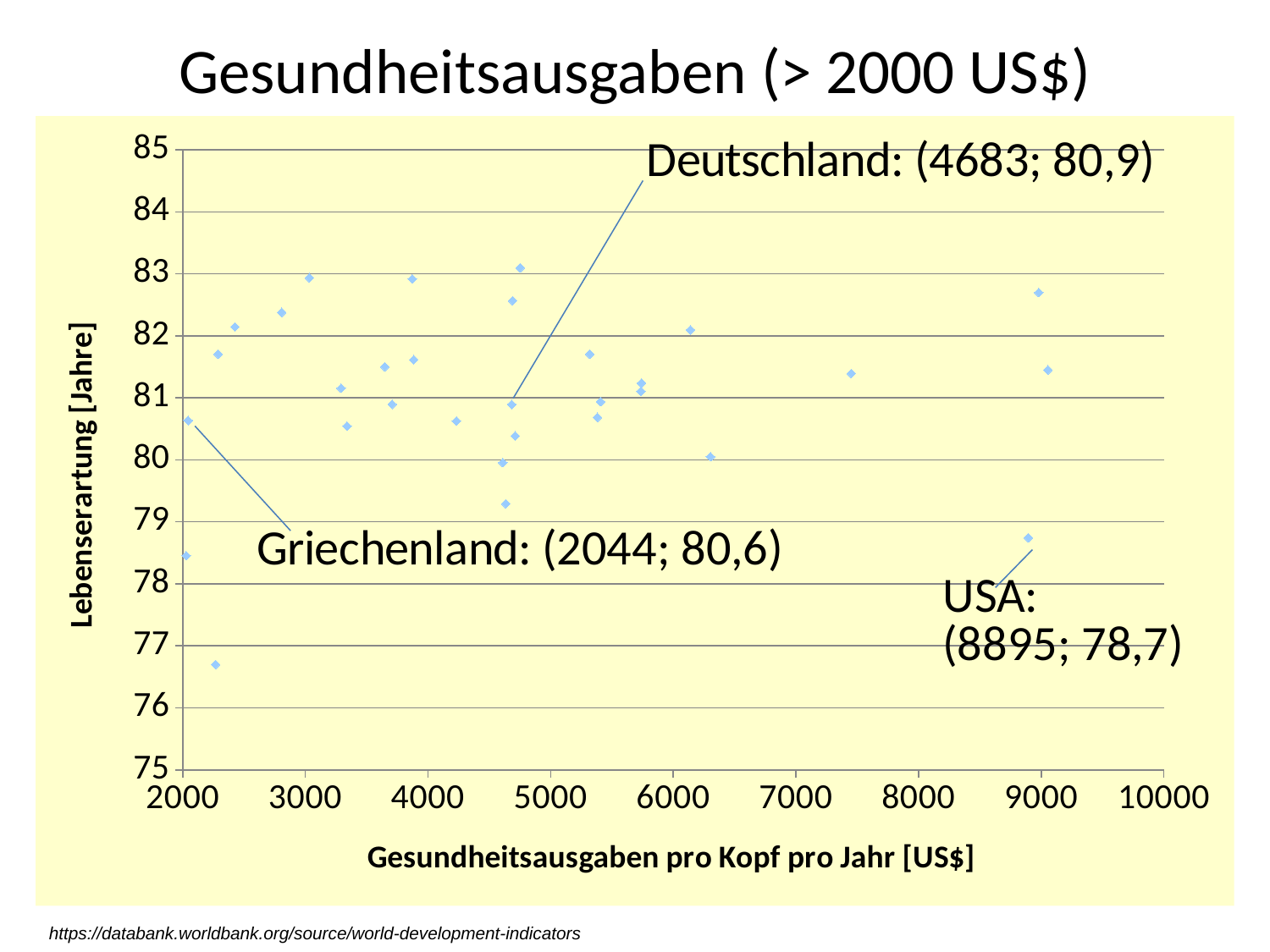
How much higher is the life expectancy of Deutschland than that of the USA? 2,2 Is the life expectancy for the USA greater or less than 80? less Which of the three labelled countries has the highest health expenditure per capita? USA Which of the three labelled countries has the lowest life expectancy? USA Which has the higher life expectancy, Deutschland or Griechenland? Deutschland What is the health expenditure per capita shown for Griechenland? 2044 What kind of chart is shown on the slide? Scatter chart What are the health expenditure and life expectancy values shown for Deutschland? 4683; 80,9 What is the difference in health expenditure per capita between the USA and Deutschland? 4212 What is the health expenditure per capita shown for the USA? 8895 What is the label of the x axis? Gesundheitsausgaben pro Kopf pro Jahr [US$] What life expectancy is shown for the USA? 78,7